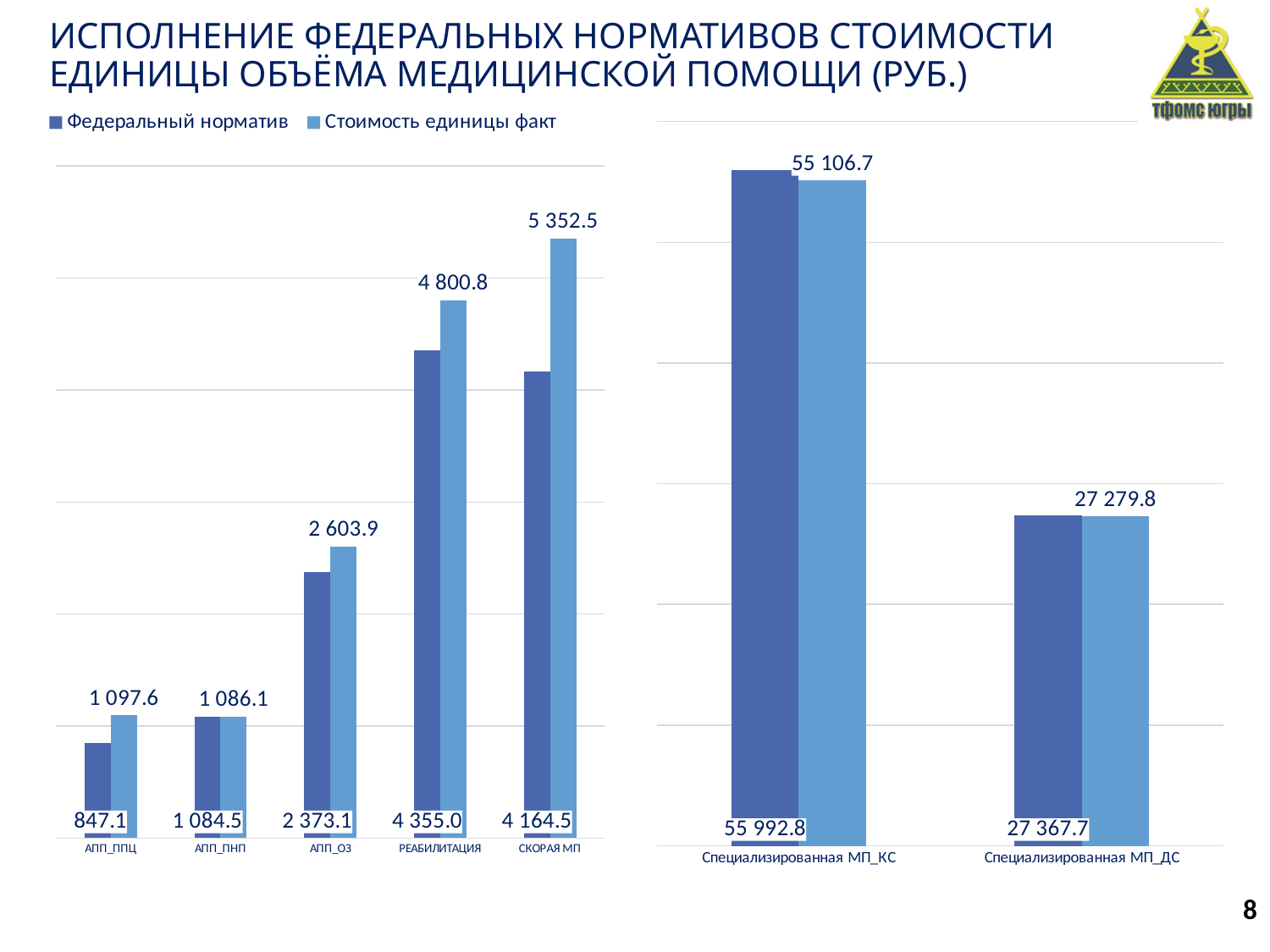
On the left chart, which category has the highest Стоимость единицы факт value? СКОРАЯ МП On the right chart, what is the Федеральный норматив value for Специализированная МП_КС? 55 992.8 On the right chart, what is the Стоимость единицы факт value for Специализированная МП_ДС? 27 279.8 On the left chart, what is the difference between the Стоимость единицы факт and Федеральный норматив values for СКОРАЯ МП? 1 188.0 How many series does the legend list? 2 On the left chart, what is the Федеральный норматив value for АПП_ППЦ? 847.1 On the left chart, what is the Стоимость единицы факт value for СКОРАЯ МП? 5 352.5 On the right chart, which is larger for Специализированная МП_КС: the Федеральный норматив or the Стоимость единицы факт? Федеральный норматив On the right chart, what is the difference between the Федеральный норматив and Стоимость единицы факт values for Специализированная МП_КС? 886.1 How many categories are shown on the left chart? 5 On the left chart, which is larger for РЕАБИЛИТАЦИЯ: the Федеральный норматив or the Стоимость единицы факт? Стоимость единицы факт On the left chart, which category has the lowest Федеральный норматив value? АПП_ППЦ